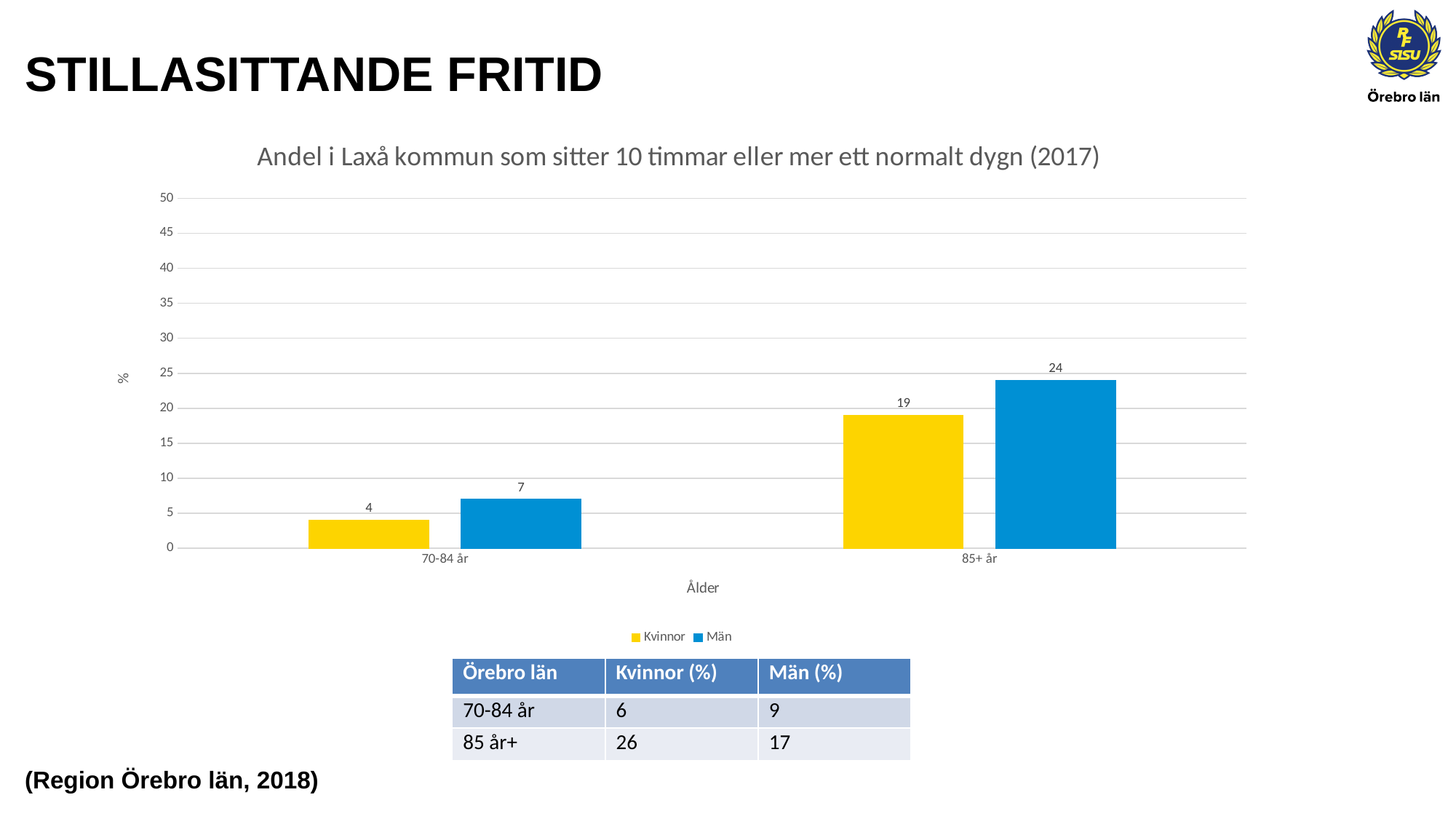
Which series has the highest value in the 85+ år category? Män What is the value for Kvinnor in the 70-84 år category? 4 What is the value for Kvinnor in the 85+ år category? 19 How many series does the legend list? 2 What is the label of the y axis? % What is the value for Män in the 85+ år category? 24 Which bar has the lowest value on the chart? Kvinnor, 70-84 år What is the difference between Män and Kvinnor in the 85+ år category? 5 What is the difference between Män and Kvinnor in the 70-84 år category? 3 How many age categories are shown on the x axis? 2 Which is larger: Män for 70-84 år or Kvinnor for 85+ år? Kvinnor for 85+ år What kind of chart is shown on the slide? Bar chart